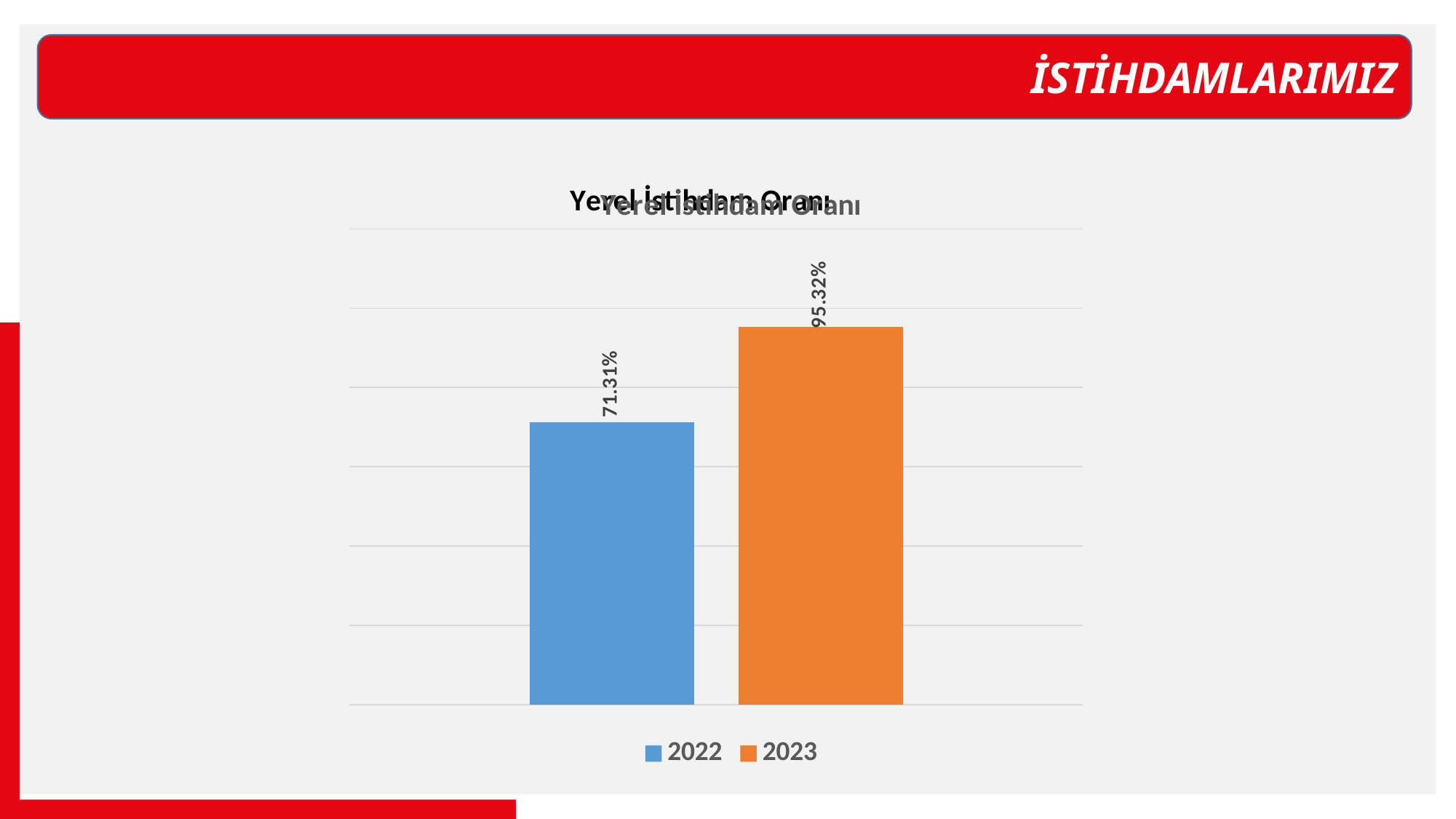
Which year has the lower value in the Yerel İstihdam Oranı chart? 2022 What is the value for 2022 in the Yerel İstihdam Oranı chart? 71.31% Is the value for 2022 larger or smaller than the value for 2023 in the Yerel İstihdam Oranı chart? smaller Does the value rise or fall from 2022 to 2023 in the Yerel İstihdam Oranı chart? rise How many series does the legend of the Yerel İstihdam Oranı chart list? 2 What kind of chart is shown on the slide? bar chart Which colour represents 2023 in the Yerel İstihdam Oranı chart? orange Which year has the higher value in the Yerel İstihdam Oranı chart? 2023 How many bars are plotted in the Yerel İstihdam Oranı chart? 2 What is the difference between the 2023 and 2022 values in the Yerel İstihdam Oranı chart? 24.01% What is the title of the chart on the slide? Yerel İstihdam Oranı What is the value for 2023 in the Yerel İstihdam Oranı chart? 95.32%